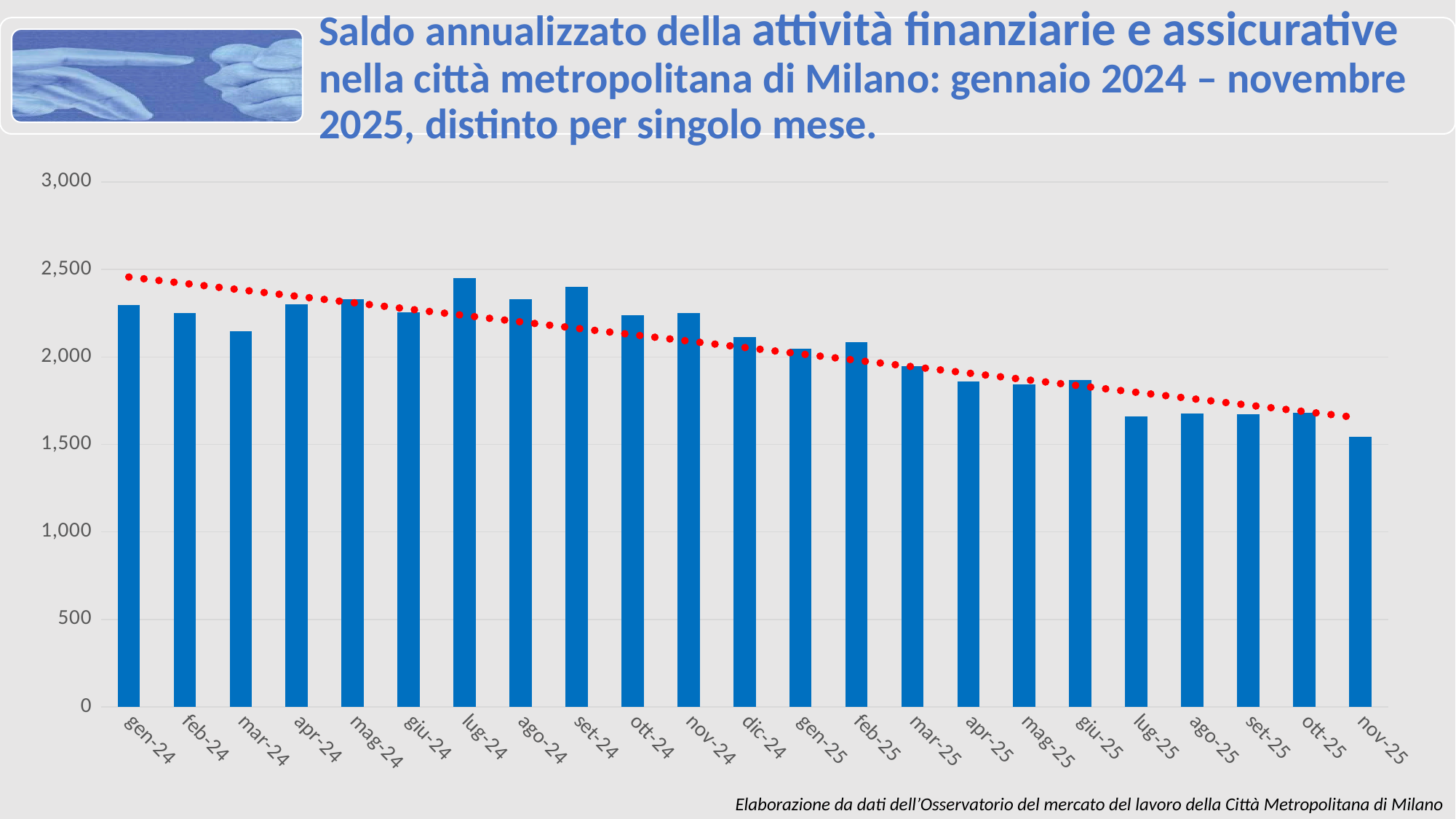
Is the value for lug-24 greater or less than 2,500? less Which is larger, the value for gen-24 or the value for mar-24? gen-24 Which month has the highest value on the chart? lug-24 Is the value for apr-25 greater or less than 2,000? less Is the value for gen-24 greater or less than 2,000? greater What kind of chart is shown on the slide? Bar chart Do the values generally rise or fall from gen-24 to nov-25? fall Which is larger, the value for giu-25 or the value for lug-25? giu-25 What does the red dotted line on the chart represent? A trend line Which month has the lowest value on the chart? nov-25 How many months (bars) are plotted on the chart? 23